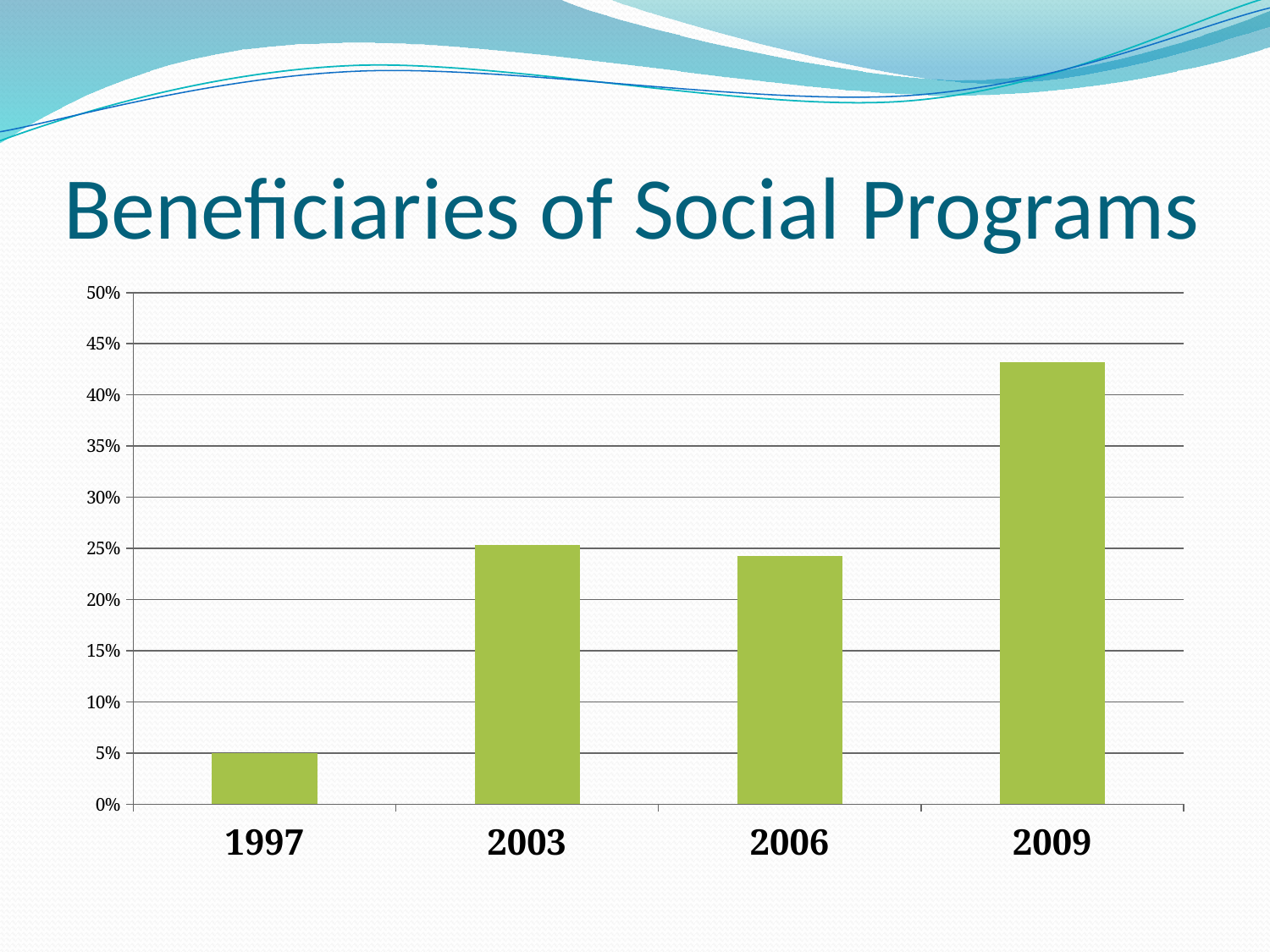
How many years are shown on the x axis of the chart? 4 What kind of chart is shown on the slide? bar chart Is the value for 2009 greater or less than 40%? greater What is the title of the chart? Beneficiaries of Social Programs What is the value for 1997? 5% Is the value for 2003 greater or less than 20%? greater Which year has the highest value in the chart? 2009 Which year has the lowest value in the chart? 1997 Which is larger, the value for 2003 or the value for 2009? 2009 Which is larger, the value for 1997 or the value for 2006? 2006 Is the value for 2009 greater or less than 45%? less